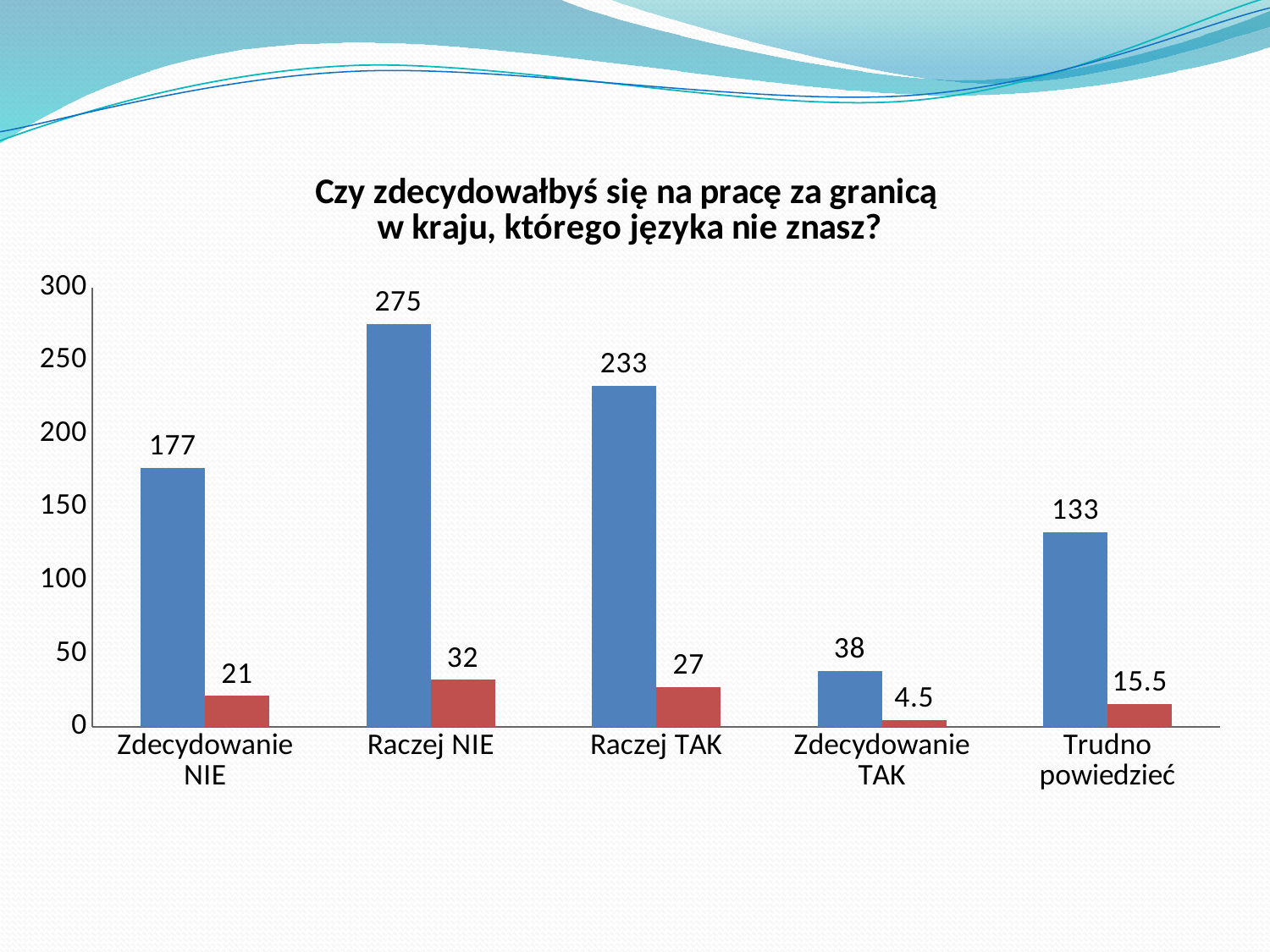
Which category has the highest blue bar? Raczej NIE What is the value of the blue bar for "Raczej NIE"? 275 What kind of chart is shown on the slide? bar chart What is the difference between the blue bars for "Raczej NIE" and "Raczej TAK"? 42 Which category has the lowest red bar? Zdecydowanie TAK What is the value of the red bar for "Raczej TAK"? 27 What is the value of the red bar for "Zdecydowanie TAK"? 4.5 How many categories are shown on the x axis? 5 Which is larger: the blue bar for "Zdecydowanie NIE" or the blue bar for "Trudno powiedzieć"? Zdecydowanie NIE Is the blue bar for "Zdecydowanie TAK" greater or less than 50? less What is the value of the blue bar for "Trudno powiedzieć"? 133 What is the title of the chart? Czy zdecydowałbyś się na pracę za granicą w kraju, którego języka nie znasz?